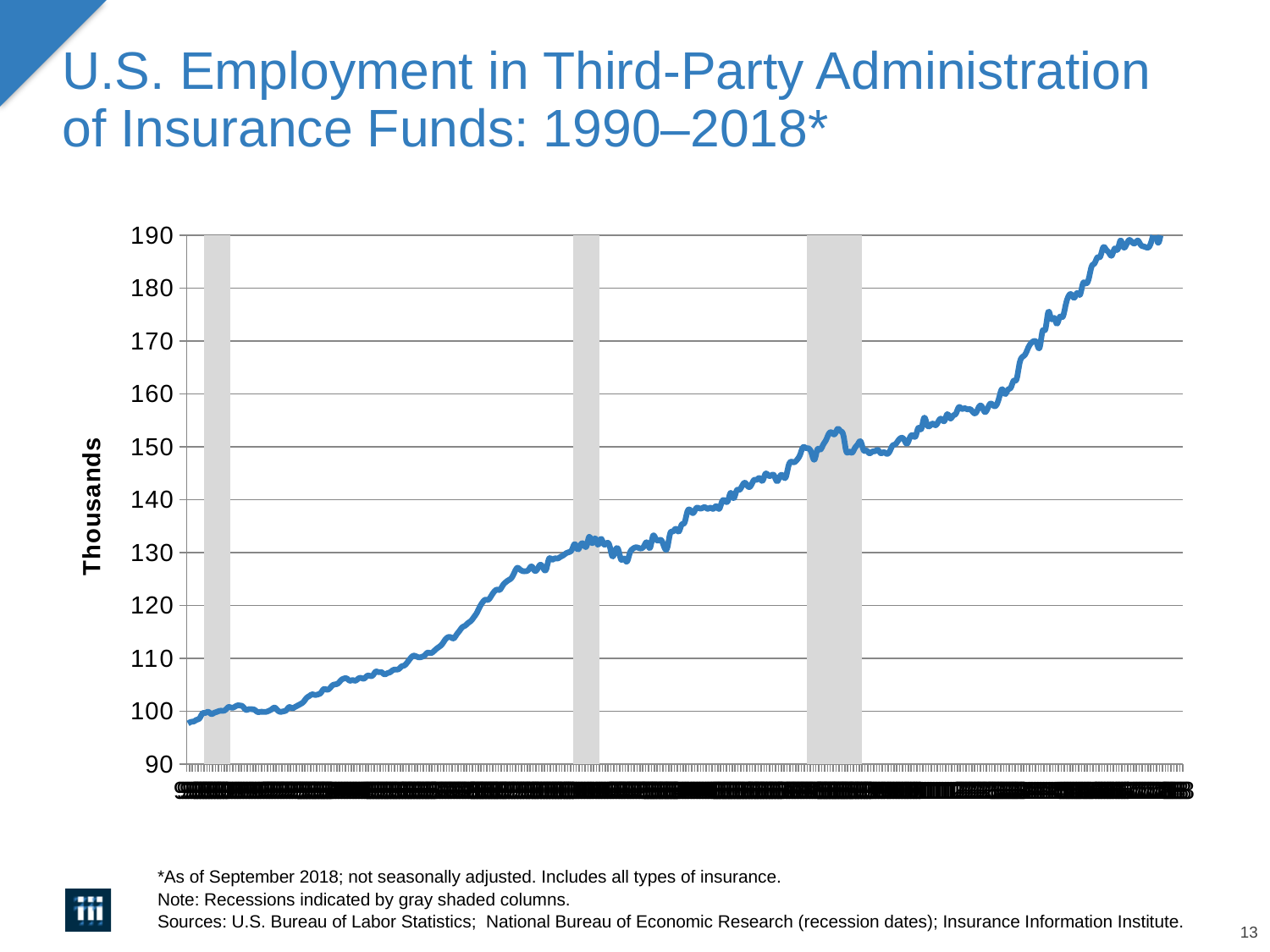
Is the value at the right-hand end of the line greater or less than 180? greater Is the lowest point of the line greater or less than 120? less What is the label on the vertical axis? Thousands Do the values generally rise or fall from left to right along the x axis? rise What is the highest value shown on the vertical axis? 190 Is the highest point of the line greater or less than 170? greater What kind of chart is shown on the slide? line chart What is the lowest value shown on the vertical axis? 90